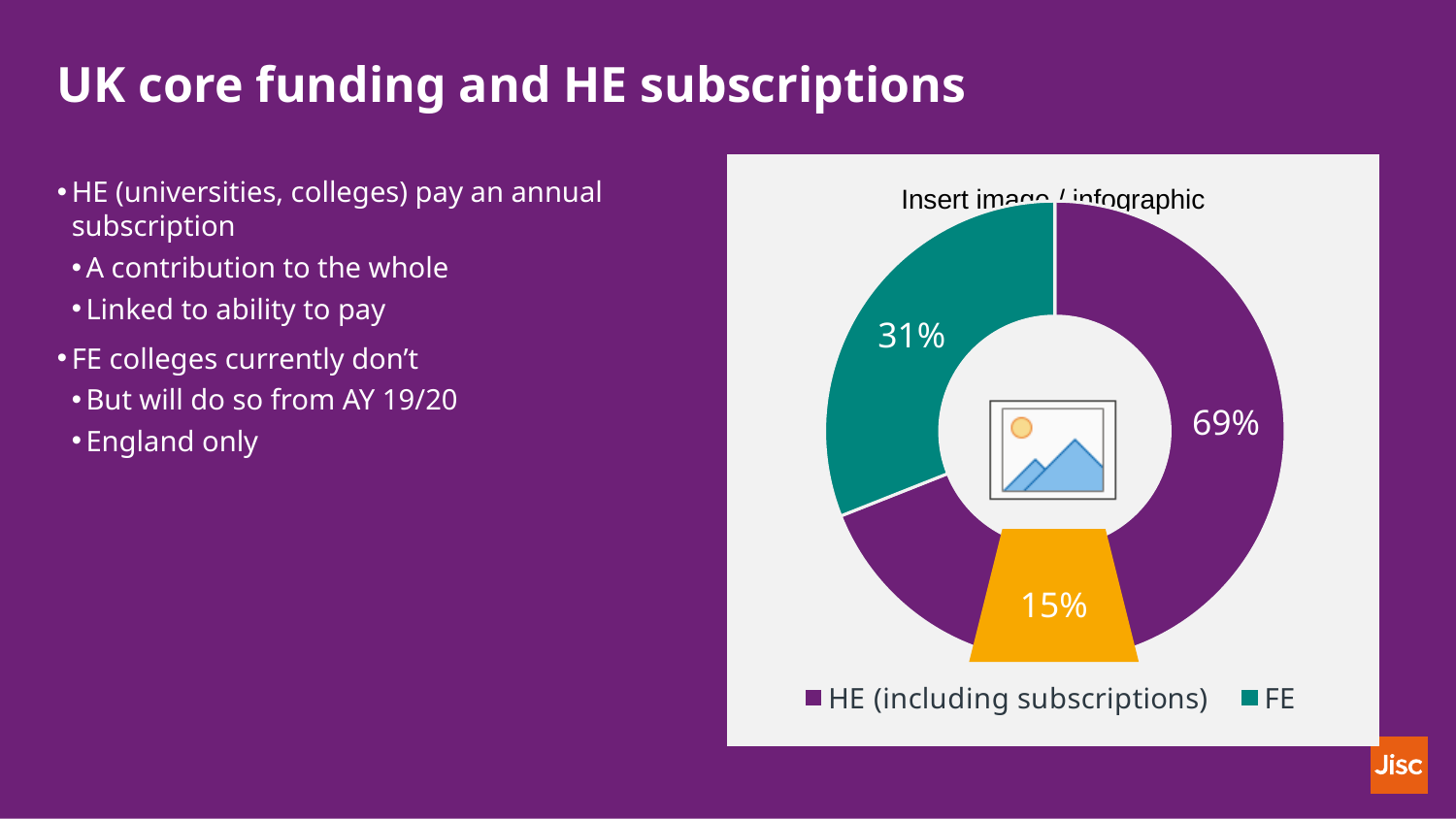
Which category has the smallest share of the chart? FE Which category has the largest share of the chart? HE (including subscriptions) What colour represents FE in the chart? teal/green Which is larger, the share for HE (including subscriptions) or the share for FE? HE (including subscriptions) What percentage is shown for FE? 31% How many categories does the chart legend list? 2 What percentage is shown for HE (including subscriptions)? 69% What is the title shown above the chart? Insert image / infographic What kind of chart is shown on the slide? pie (doughnut) chart What value is printed on the orange segment at the bottom of the chart? 15% What is the difference in percentage points between HE (including subscriptions) and FE? 38